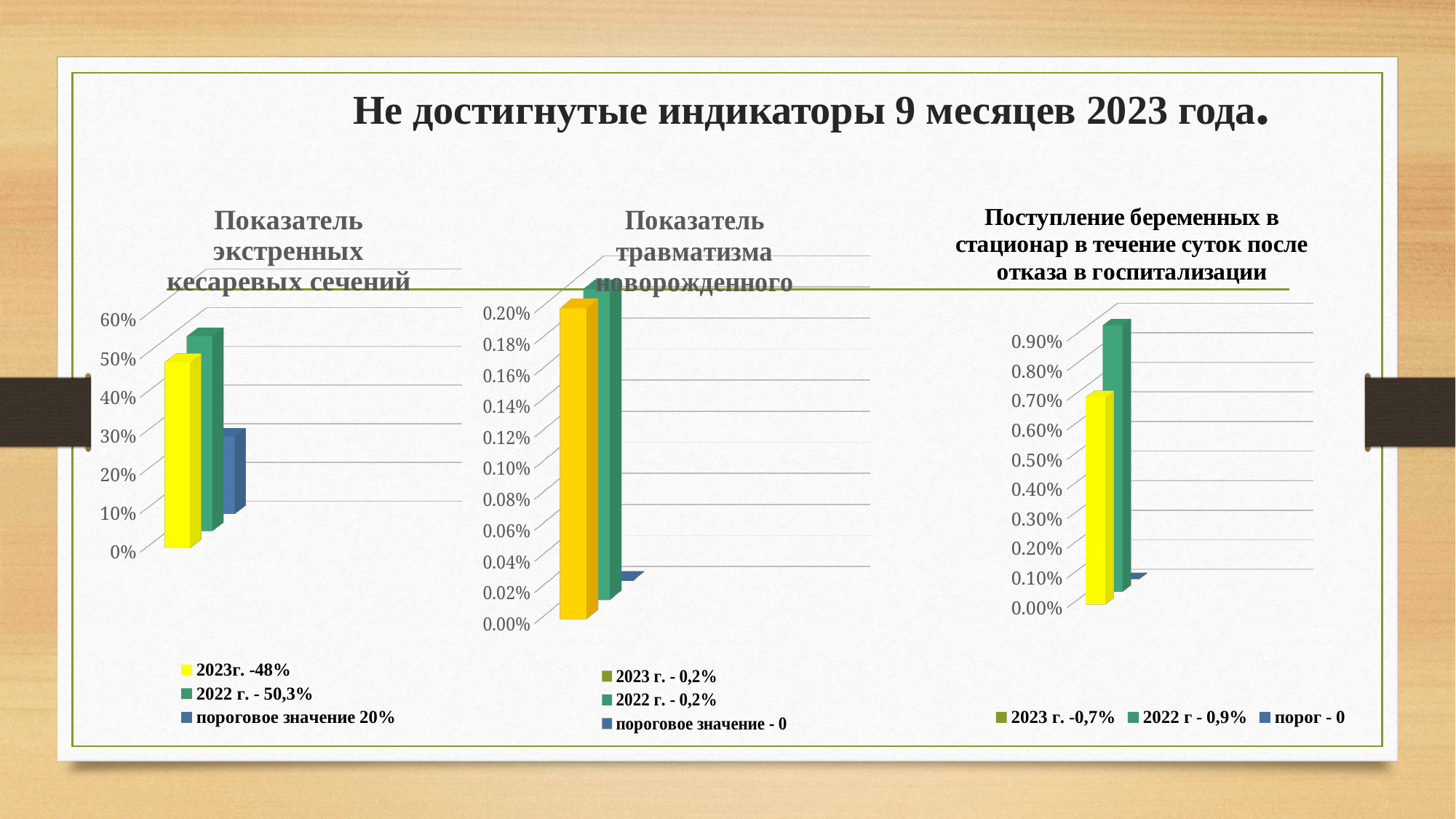
In the chart titled «Показатель экстренных кесаревых сечений», is the value for 2023 г. greater or less than 40%? greater In the chart titled «Показатель экстренных кесаревых сечений», what is the value for 2023 г.? 48% In the chart titled «Поступление беременных в стационар в течение суток после отказа в госпитализации», which series has the highest value? 2022 г In the chart titled «Показатель экстренных кесаревых сечений», what is the difference between the 2022 г. value and the 2023 г. value? 2,3% In the chart titled «Поступление беременных в стационар в течение суток после отказа в госпитализации», what is the value for 2023 г.? 0,7% How many series does the legend of the chart titled «Показатель экстренных кесаревых сечений» list? 3 In the chart titled «Показатель экстренных кесаревых сечений», which is larger: the value for 2022 г. or for 2023 г.? 2022 г. What kind of chart is the chart titled «Показатель травматизма новорожденного»? bar chart In the chart titled «Показатель экстренных кесаревых сечений», what is the value for 2022 г.? 50,3% In the chart titled «Показатель травматизма новорожденного», what is the value for 2023 г.? 0,2% In the chart titled «Показатель экстренных кесаревых сечений», what is the пороговое значение (threshold value)? 20% How many charts are shown on the slide? 3